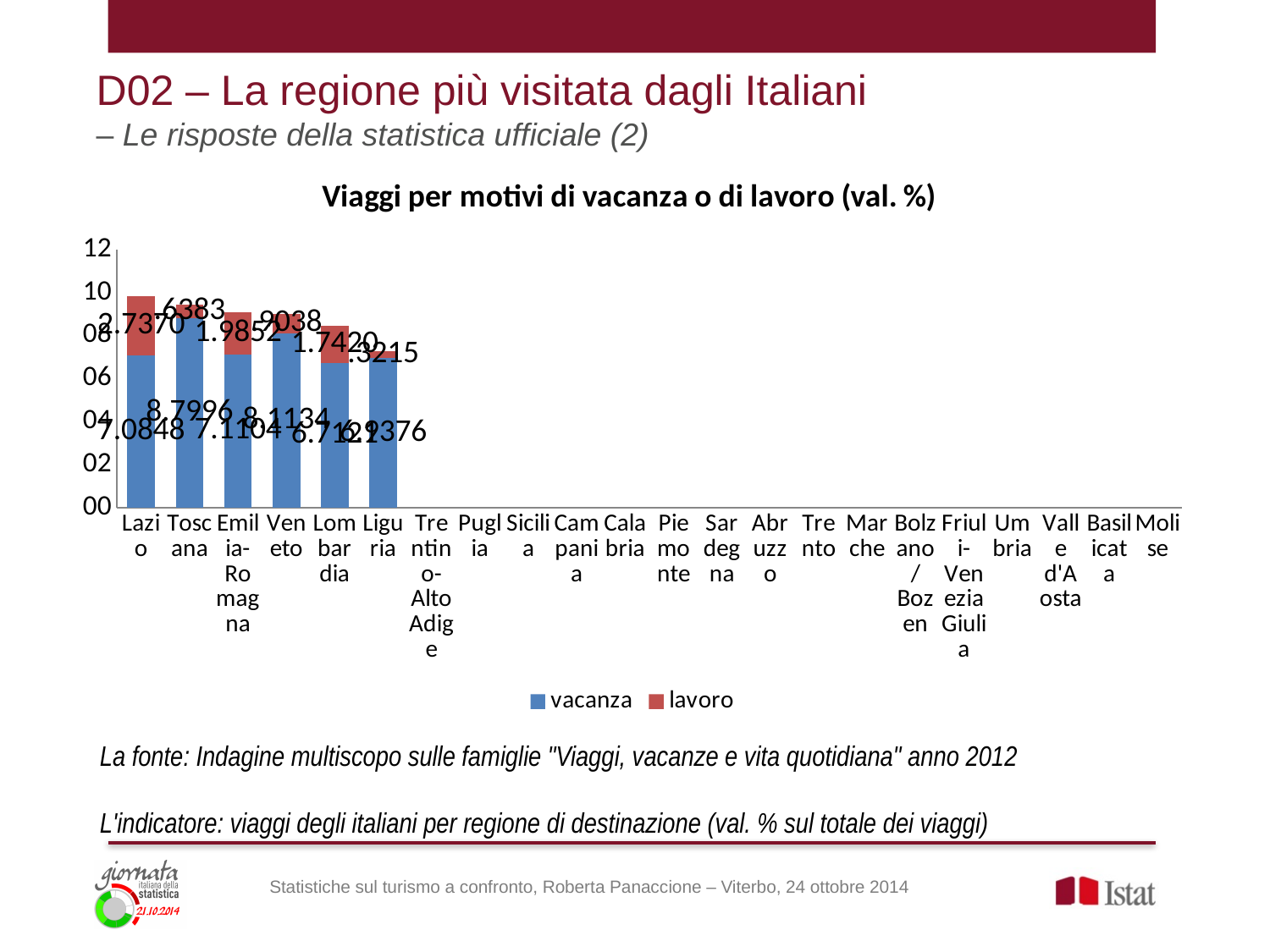
Among the regions with plotted bars, which has the shortest stacked bar? Liguria How many regions have a visible bar plotted in the chart? 6 Which region has the largest 'lavoro' segment? Lazio What kind of chart is shown on the slide? Stacked bar chart Which region has the tallest stacked bar? Lazio Is the total stacked bar for Lazio greater or less than 8? greater How many series does the legend list? 2 What is the title of the chart? Viaggi per motivi di vacanza o di lavoro (val. %) Is the total stacked bar for Liguria greater or less than 8? less Which is larger, the stacked bar for Toscana or the stacked bar for Lombardia? Toscana How many regions are listed along the x axis? 22 What are the two series named in the legend? vacanza and lavoro